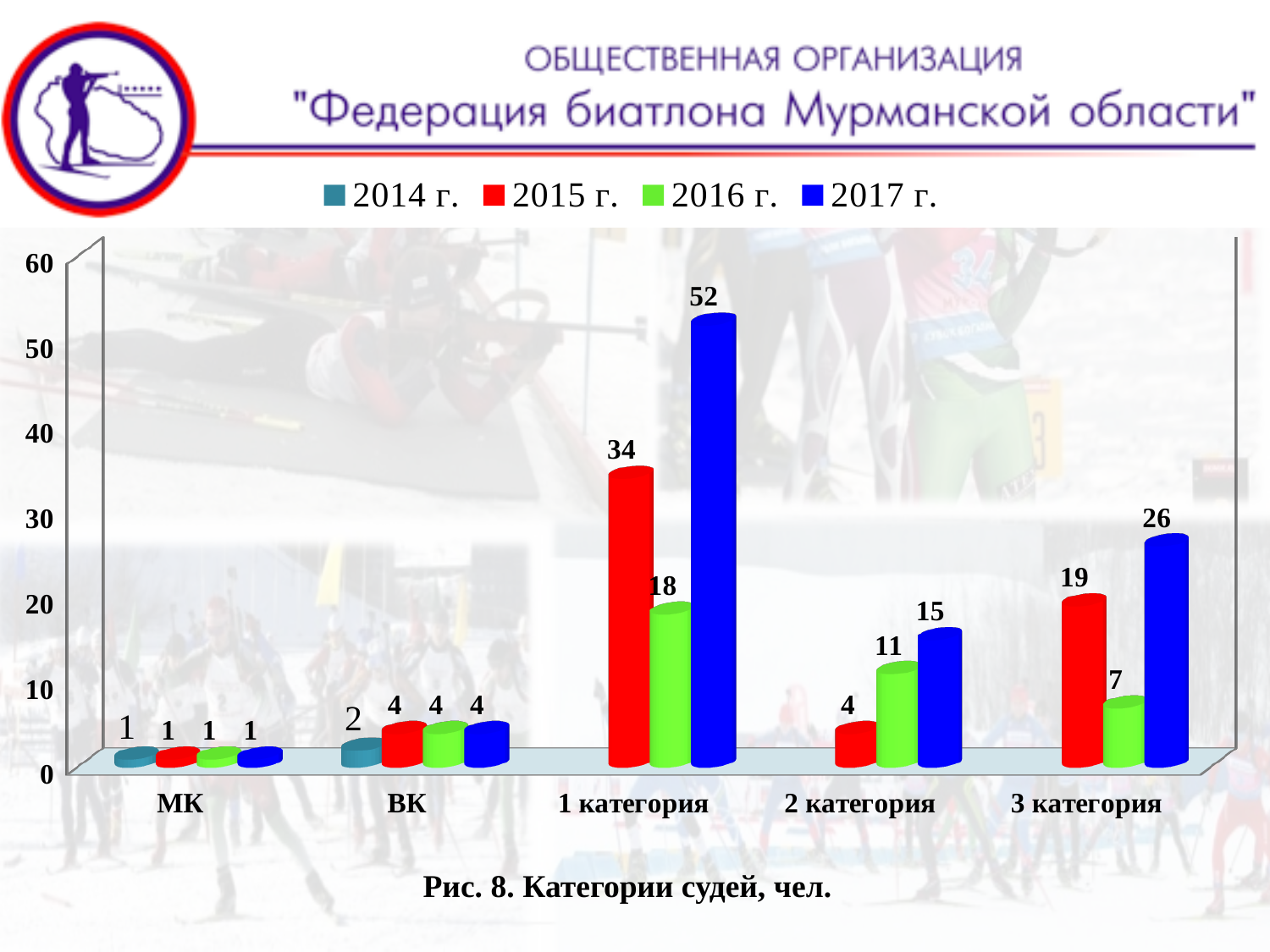
How many categories are shown on the x axis? 5 What is the value for 2017 г. in the 1 категория group? 52 What is the difference between the 2017 г. and 2015 г. values in the 1 категория group? 18 What kind of chart is shown on the slide? Bar chart Which is larger in the 3 категория group: the 2016 г. value or the 2017 г. value? 2017 г. What is the value for 2015 г. in the 3 категория group? 19 How many series does the legend list? 4 Which category has the highest value for 2017 г.? 1 категория Which category has the lowest value for 2016 г.? МК What is the value for 2016 г. in the 2 категория group? 11 What is the value for 2014 г. in the ВК group? 2 What is the caption of the chart? Рис. 8. Категории судей, чел.